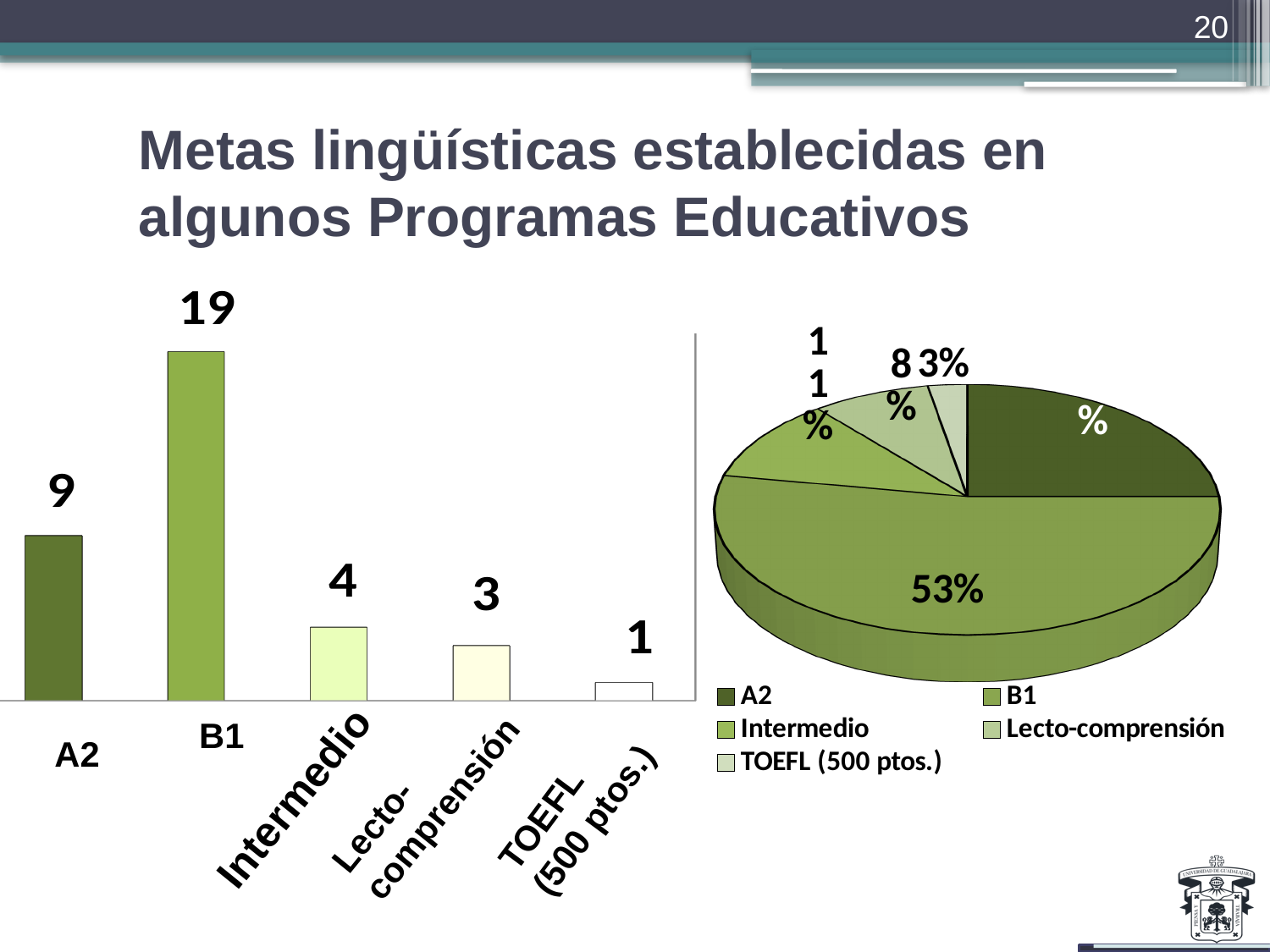
On the bar chart on the left, which is larger, the value for Intermedio or the value for Lecto-comprensión? Intermedio On the bar chart on the left, which category has the highest value? B1 On the bar chart on the left, what is the difference between the values for B1 and A2? 10 On the bar chart on the left, what is the value for Lecto-comprensión? 3 On the bar chart on the left, which category has the lowest value? TOEFL (500 ptos.) On the bar chart on the left, what is the value for TOEFL (500 ptos.)? 1 What kind of chart is on the right side of the slide? Pie chart On the bar chart on the left, what is the value for B1? 19 On the bar chart on the left, what is the value for A2? 9 How many entries does the legend of the pie chart on the right list? 5 How many categories are shown on the bar chart on the left? 5 On the pie chart on the right, what share does B1 have? 53%